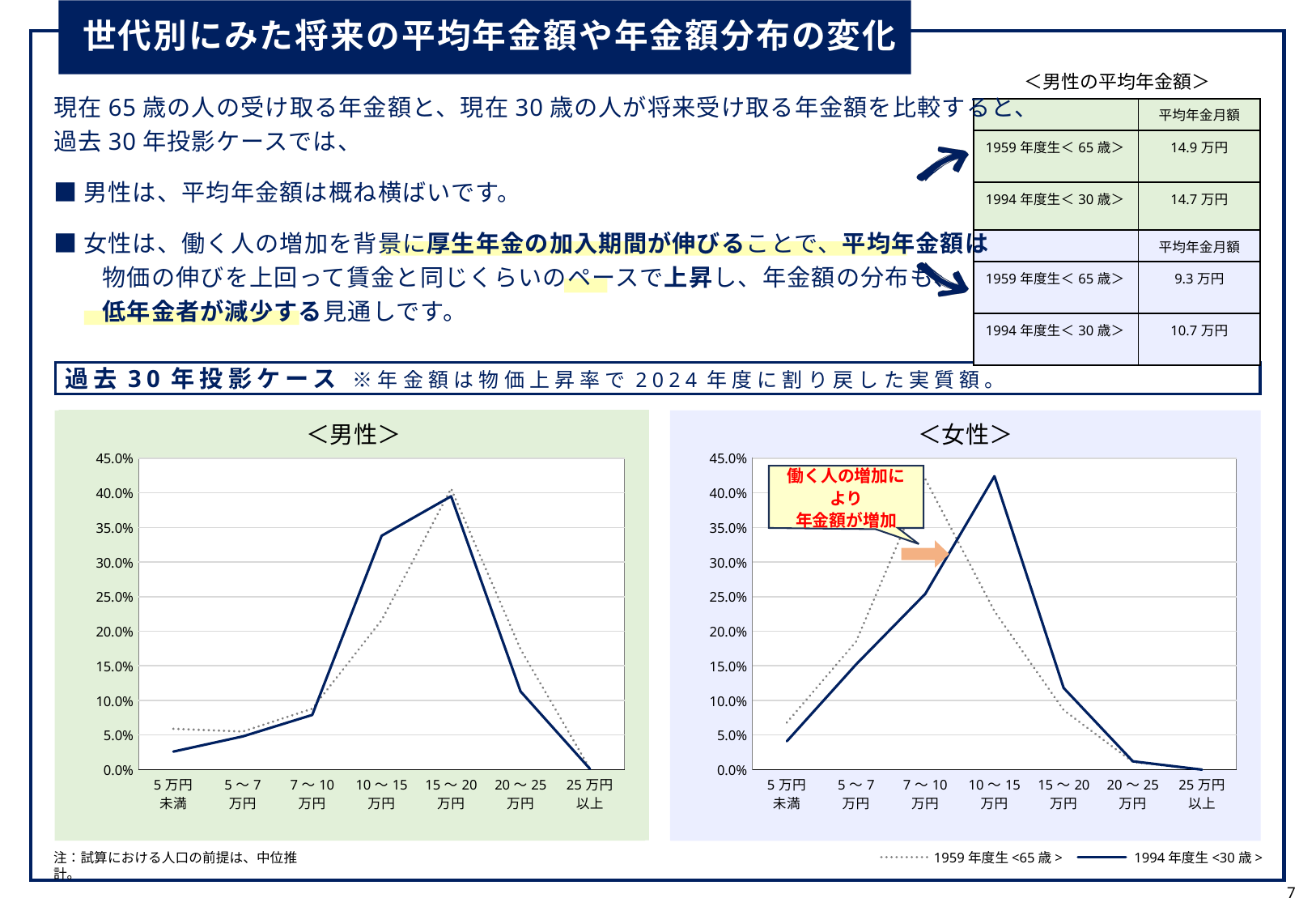
In the <女性> chart, is the value of the 1994年度生<30歳> series at 10～15万円 greater or less than 40.0%? greater In the <女性> chart, at which category does the 1994年度生<30歳> series reach its highest value? 10～15万円 What kind of chart is the <男性> chart? line chart In the <男性> chart, at which category does the 1994年度生<30歳> series reach its highest value? 15～20万円 In the <男性> chart, at which category is the 1994年度生<30歳> series lowest? 25万円以上 In the <女性> chart, does the 1994年度生<30歳> series rise or fall from 10～15万円 to 25万円以上? fall In the <男性> chart, is the value of the 1994年度生<30歳> series at 15～20万円 greater or less than 35.0%? greater How many income categories are shown on the x axis of the <女性> chart? 7 In the <女性> chart, at 7～10万円, which series has the larger value: 1959年度生<65歳> or 1994年度生<30歳>? 1959年度生<65歳> How many series does the legend list for the charts? 2 In the <女性> chart, at which category does the 1959年度生<65歳> series reach its highest value? 7～10万円 In the <男性> chart, at 10～15万円, which series has the larger value: 1959年度生<65歳> or 1994年度生<30歳>? 1994年度生<30歳>